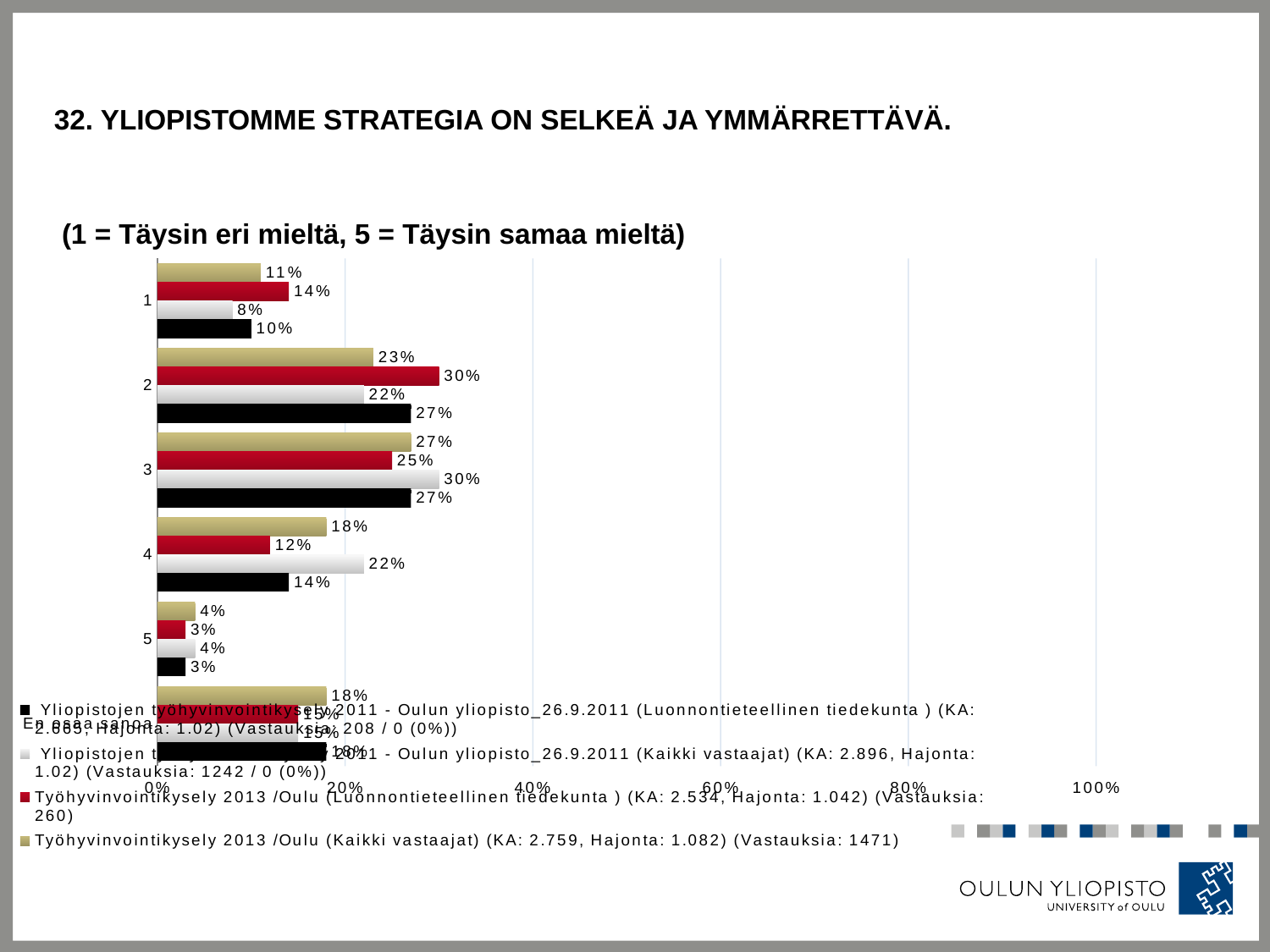
What type of chart is shown on the slide? bar chart What is the value of the red bar (2013, Luonnontieteellinen tiedekunta) for category 5? 3% How many series does the legend list? 4 For the red series (2013, Luonnontieteellinen tiedekunta), which category from 1 to 5 has the highest value? 2 What is the value of the red bar (Työhyvinvointikysely 2013 /Oulu, Luonnontieteellinen tiedekunta) for category 2? 30% What is the difference between the red bar (30%) and the light gray bar (22%) for category 2? 8% For the light gray series (2011, Kaikki vastaajat), which category from 1 to 5 has the lowest value? 5 Is the value of the light gray bar for category 3 greater or less than 20%? greater What is the value of the black bar (2011, Luonnontieteellinen tiedekunta) for category 1? 10% What is the value of the light gray bar (2011, Kaikki vastaajat) for category 4? 22% For category 4, which is larger: the gold bar (2013, Kaikki vastaajat) or the red bar (2013, Luonnontieteellinen tiedekunta)? gold bar (2013, Kaikki vastaajat) What is the value of the gold bar (Työhyvinvointikysely 2013 /Oulu, Kaikki vastaajat) for category 3? 27%